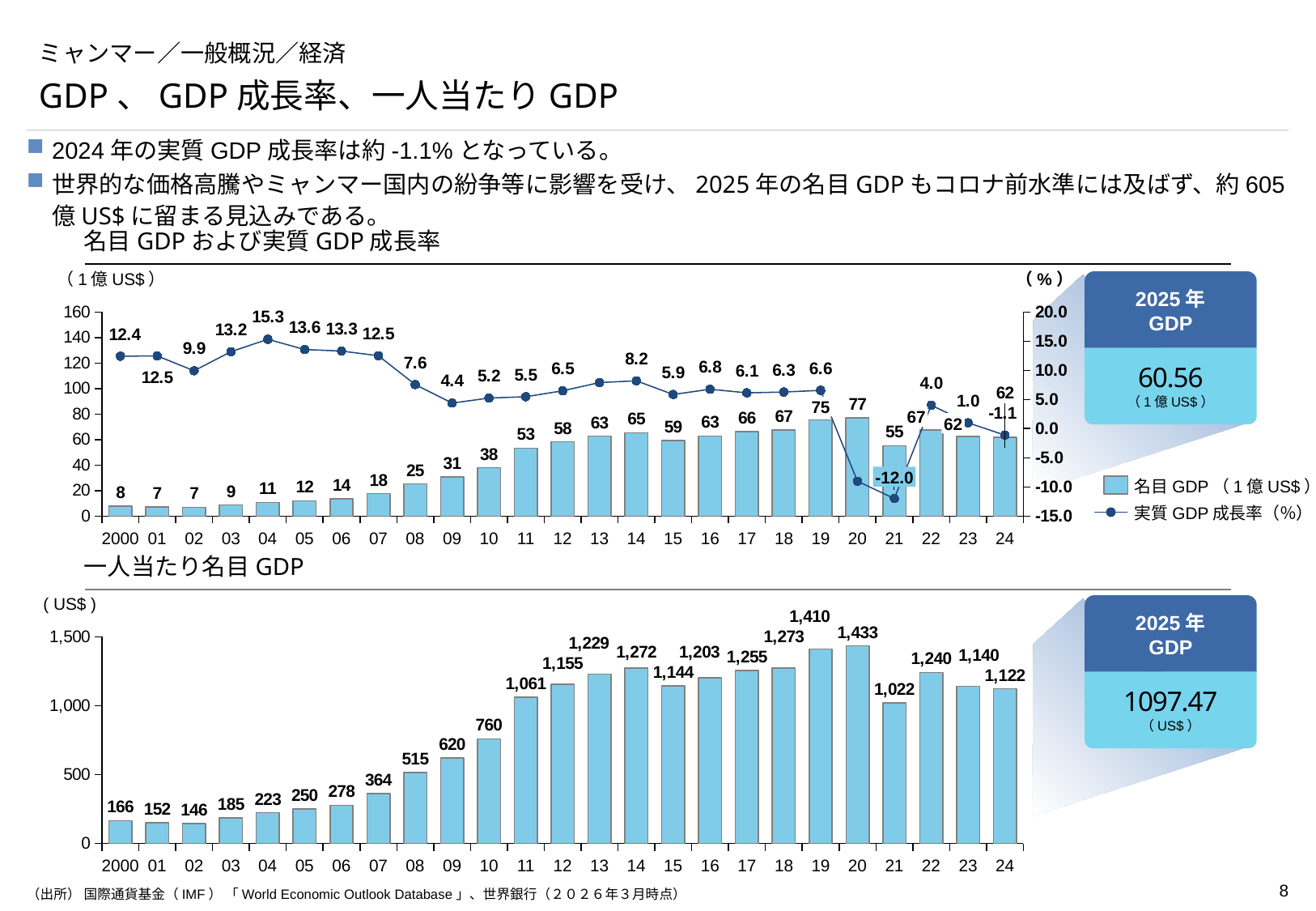
In the bottom chart (一人当たり名目GDP), which year has the highest value? 2020 In the top chart (名目GDPおよび実質GDP成長率), what is the real GDP growth rate for 2004? 15.3 In the top chart (名目GDPおよび実質GDP成長率), what is the difference between the nominal GDP of 2020 and 2021? 22 In the top chart (名目GDPおよび実質GDP成長率), what is the lowest real GDP growth rate shown with a data label? -12.0 In the top chart (名目GDPおよび実質GDP成長率), how many series does the legend list? 2 In the bottom chart (一人当たり名目GDP), which year has the lowest value? 2002 In the bottom chart (一人当たり名目GDP), what kind of chart is it? bar chart In the bottom chart (一人当たり名目GDP), what is the value for 2019? 1,410 In the top chart (名目GDPおよび実質GDP成長率), what is the nominal GDP value for 2020? 77 In the top chart (名目GDPおよび実質GDP成長率), what is the real GDP growth rate for 2024? -1.1 In the top chart (名目GDPおよび実質GDP成長率), which year has the highest nominal GDP bar? 2020 In the bottom chart (一人当たり名目GDP), which is larger, the value for 2022 or the value for 2023? 2022